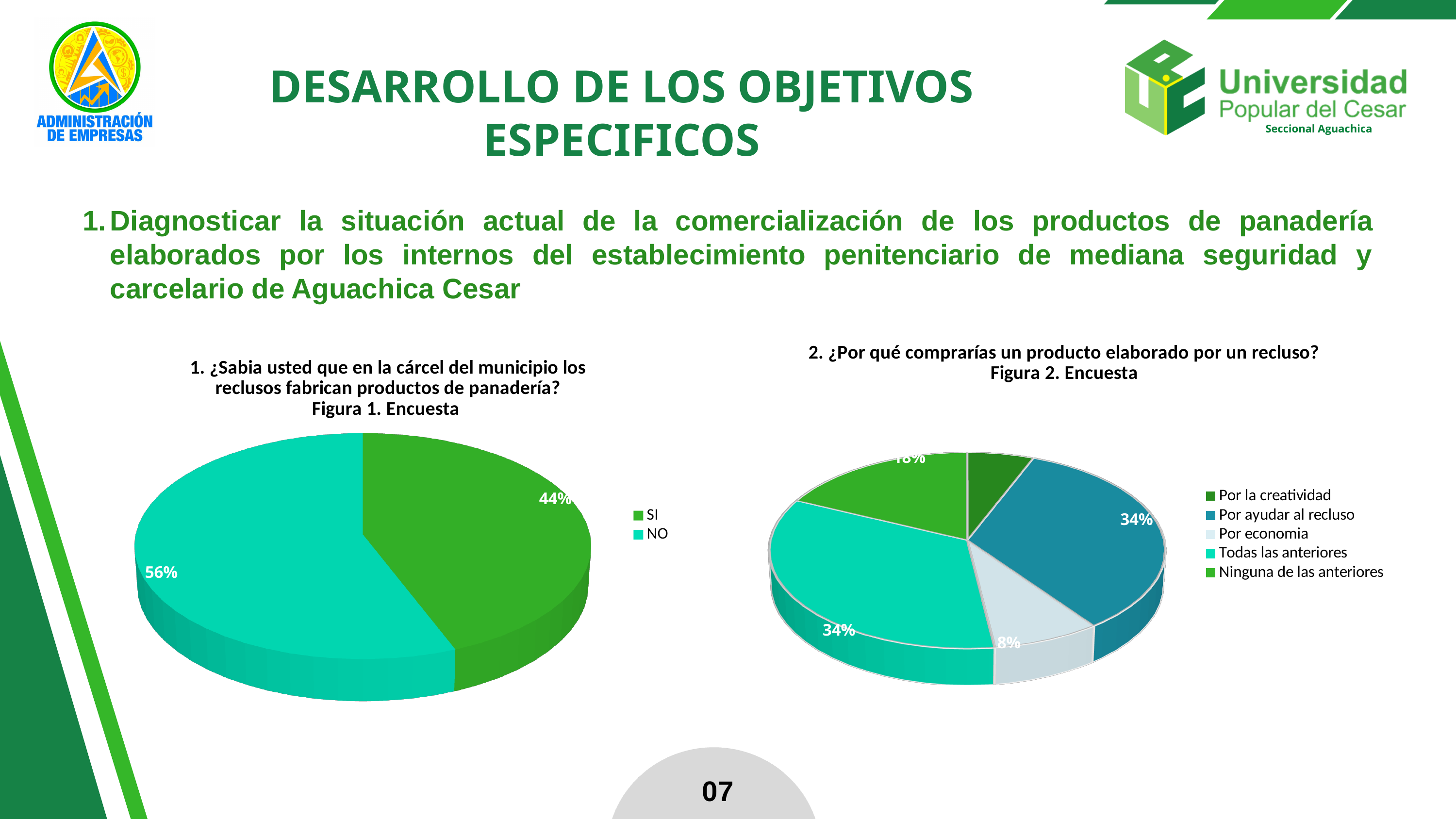
In Figura 1 (the left chart), what is the difference between the NO share and the SI share? 12% What kind of chart is Figura 2 (the right chart)? pie chart In Figura 2 (the right chart), what percentage chose 'Por economia'? 8% In Figura 1 (the left chart), what percentage answered NO? 56% What kind of chart is Figura 1 (the left chart)? pie chart In Figura 2 (the right chart), which is larger, 'Por economia' or 'Todas las anteriores'? Todas las anteriores In Figura 2 (the right chart), what percentage chose 'Por ayudar al recluso'? 34% How many entries does the legend of Figura 1 (the left chart) list? 2 In Figura 2 (the right chart), which category has the smallest slice? Por la creatividad In Figura 1 (the left chart), what percentage answered SI? 44% In Figura 1 (the left chart), which answer has the larger share, SI or NO? NO How many categories does the legend of Figura 2 (the right chart) list? 5